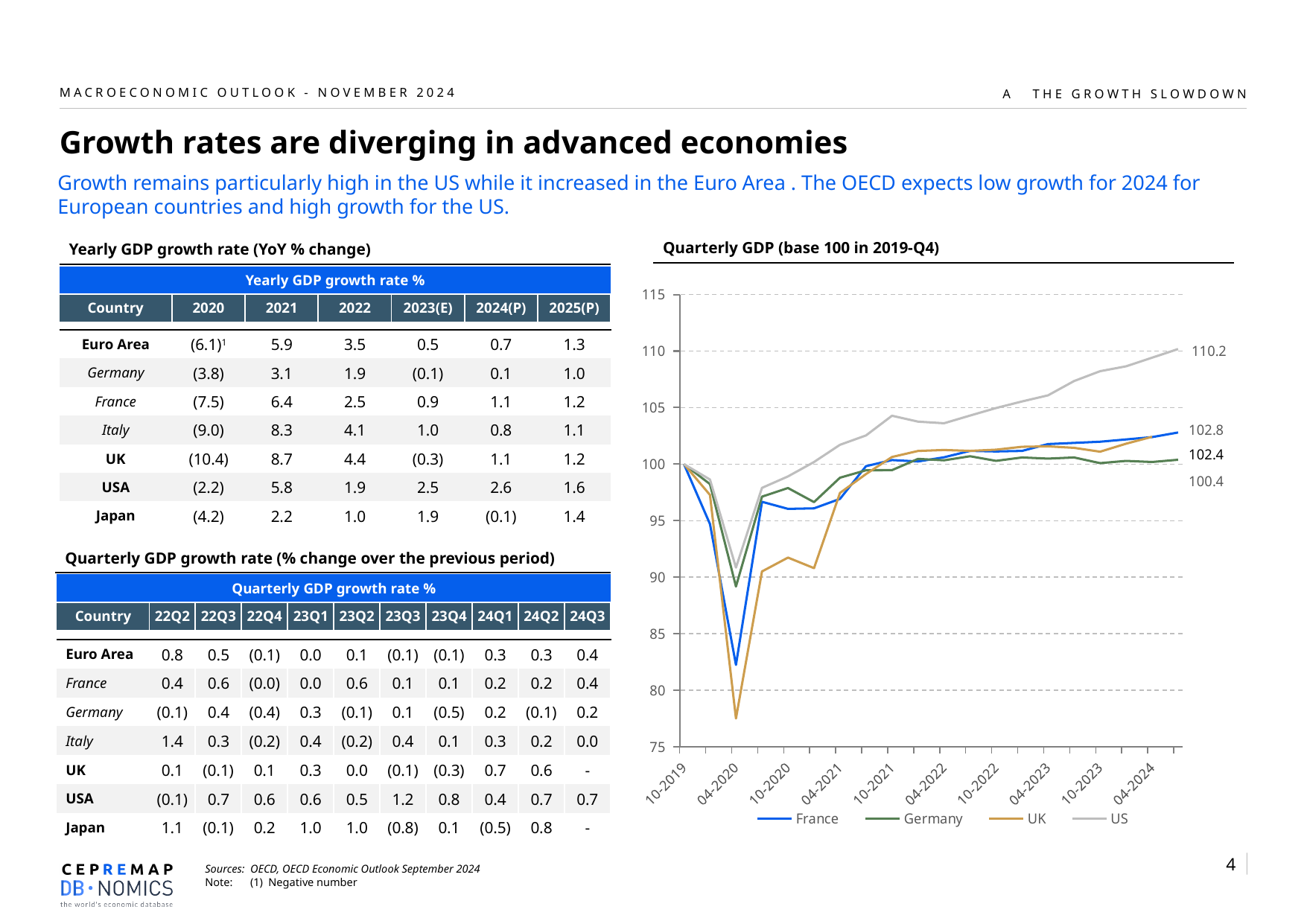
In the Quarterly GDP chart, is the value for the UK around 04-2020 greater or less than 80? less In the Quarterly GDP chart, is the value for France around 04-2020 greater or less than 85? less What is the final labelled value for Germany in the Quarterly GDP chart? 100.4 In the Quarterly GDP chart, does the US series rise or fall from 10-2020 to 04-2024? rise What is the title of the line chart on the slide? Quarterly GDP (base 100 in 2019-Q4) Which series has the highest value at the end of the Quarterly GDP chart? US Which series has the lowest value around 04-2020 in the Quarterly GDP chart? UK What kind of chart is the Quarterly GDP (base 100 in 2019-Q4) chart? line chart What is the final labelled value for France in the Quarterly GDP chart? 102.8 In the Quarterly GDP chart, what is the difference between the final labelled values for the US and Germany? 9.8 How many series does the legend of the Quarterly GDP chart list? 4 What is the final labelled value for the US in the Quarterly GDP chart? 110.2